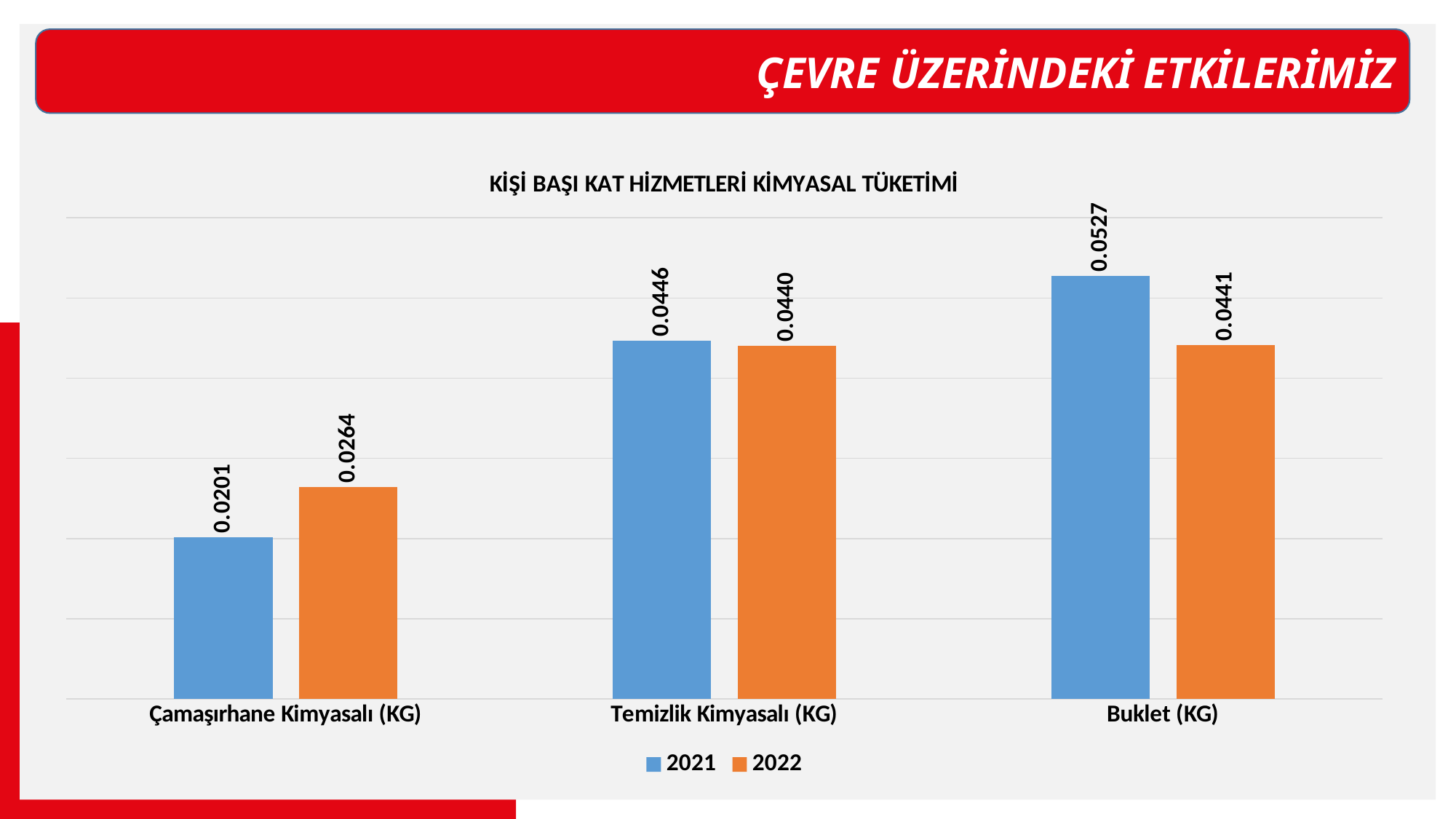
How many categories are shown on the x axis? 3 What is the 2021 value for Çamaşırhane Kimyasalı (KG)? 0.0201 Which category has the highest 2021 value? Buklet (KG) What is the 2022 value for Buklet (KG)? 0.0441 How many series does the legend list? 2 Which category has the lowest 2022 value? Çamaşırhane Kimyasalı (KG) What is the 2022 value for Temizlik Kimyasalı (KG)? 0.0440 What is the difference between the 2022 and 2021 values for Çamaşırhane Kimyasalı (KG)? 0.0063 What is the difference between the 2021 and 2022 values for Buklet (KG)? 0.0086 Which is larger for Çamaşırhane Kimyasalı (KG): the 2021 value or the 2022 value? 2022 What kind of chart is shown on the slide? Bar chart What is the title of the chart? KİŞİ BAŞI KAT HİZMETLERİ KİMYASAL TÜKETİMİ